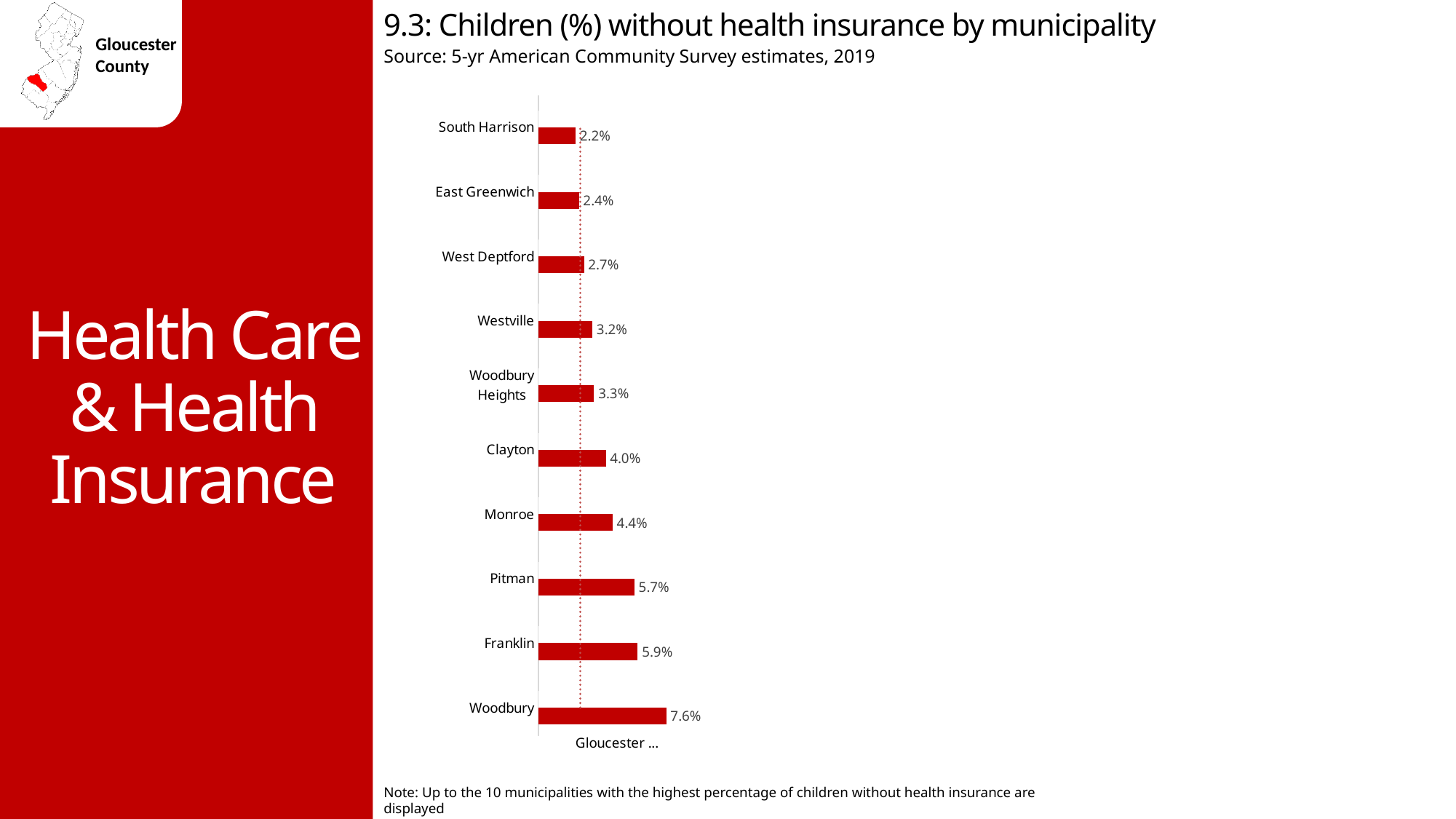
Which municipality has the highest percentage of children without health insurance? Woodbury What kind of chart is shown on the slide? Bar chart What is the title of the chart? 9.3: Children (%) without health insurance by municipality What is the value shown for Clayton? 4.0% Which has a higher value, Pitman or Monroe? Pitman How many municipalities are shown in the chart? 10 Which has a lower value, East Greenwich or West Deptford? East Greenwich Which municipality has the lowest percentage of children without health insurance? South Harrison What percentage of children in Woodbury are without health insurance? 7.6% What is the difference between the values for Monroe and Clayton? 0.4% What is the difference between the values for Woodbury and Franklin? 1.7% What is the value shown for Westville? 3.2%